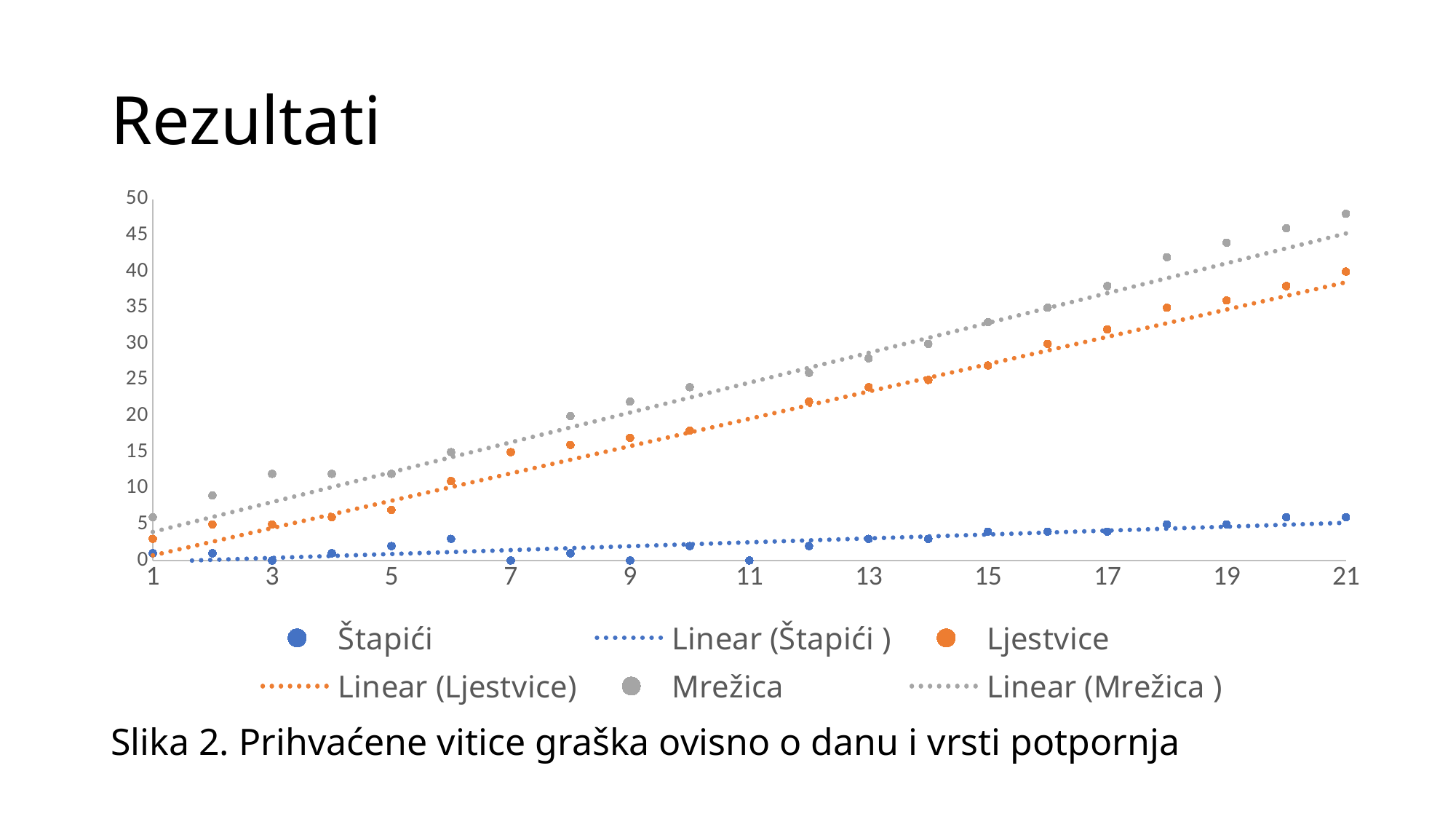
Which series has the highest value at x = 21? Mrežica How many entries does the chart legend list? 6 What kind of chart is shown on the slide? scatter chart How many data points does the Mrežica series have? 21 Is the value for Štapići at x = 21 greater or less than 10? less At x = 21, which is larger: the Mrežica value or the Ljestvice value? Mrežica What colour are the Mrežica points in the chart? grey Is the value for Mrežica at x = 21 greater or less than 45? greater Is the value for Ljestvice at x = 21 greater or less than 35? greater Which series has the lowest value at x = 21? Štapići Do the Mrežica values rise or fall as x increases from 1 to 21? rise